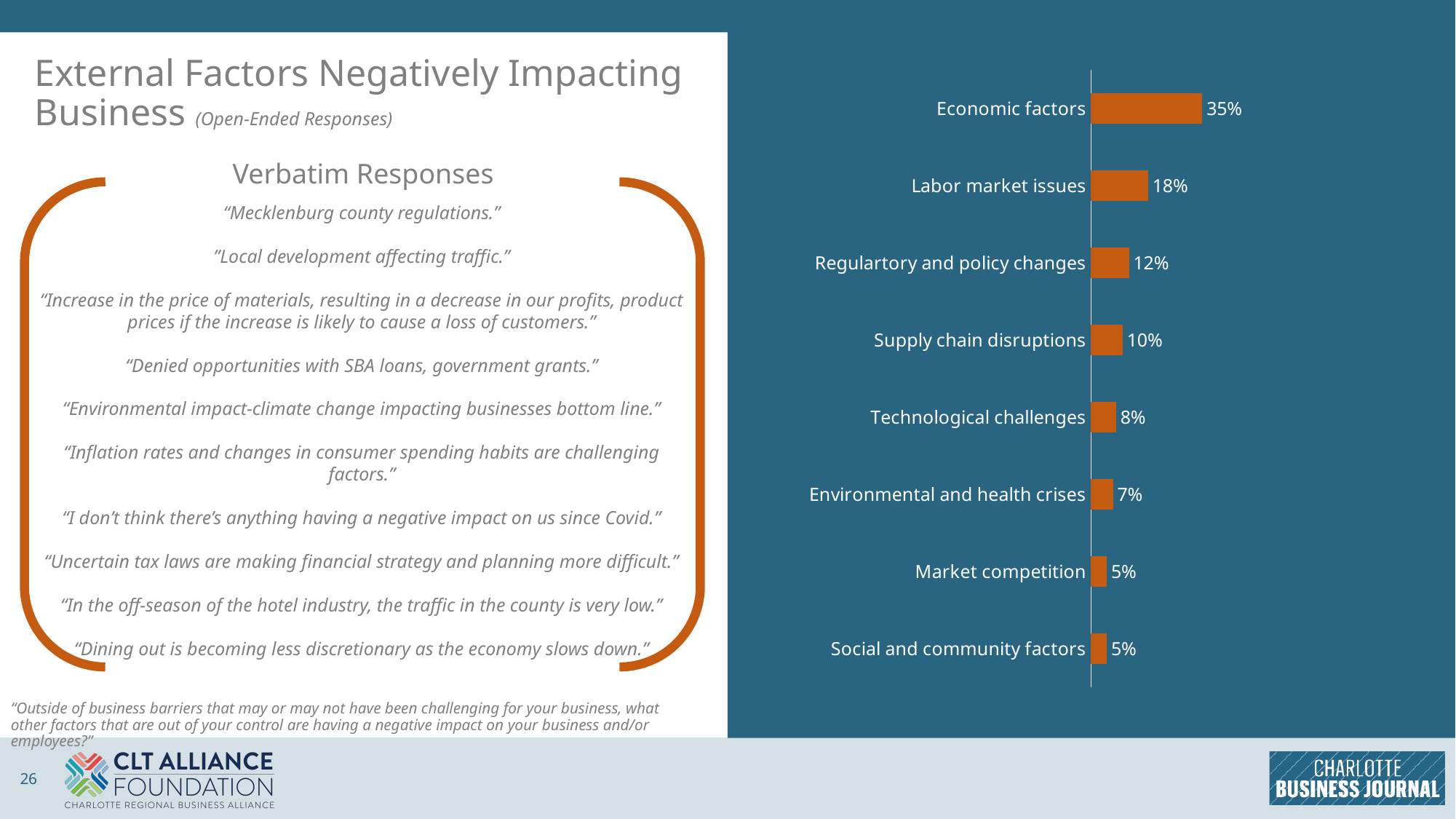
How many categories are shown in the bar chart? 8 What percentage is shown for Economic factors? 35% Which category has the highest percentage? Economic factors What is the difference in percentage points between Regulartory and policy changes and Technological challenges? 4 Which is larger, the value for Supply chain disruptions or the value for Technological challenges? Supply chain disruptions What percentage is shown for Supply chain disruptions? 10% What is the difference in percentage points between Economic factors and Labor market issues? 17 Which two categories share the lowest value of 5%? Market competition and Social and community factors What percentage is shown for Labor market issues? 18% What kind of chart is shown on the slide? Bar chart What colour are the bars in the chart? Orange What percentage is shown for Environmental and health crises? 7%